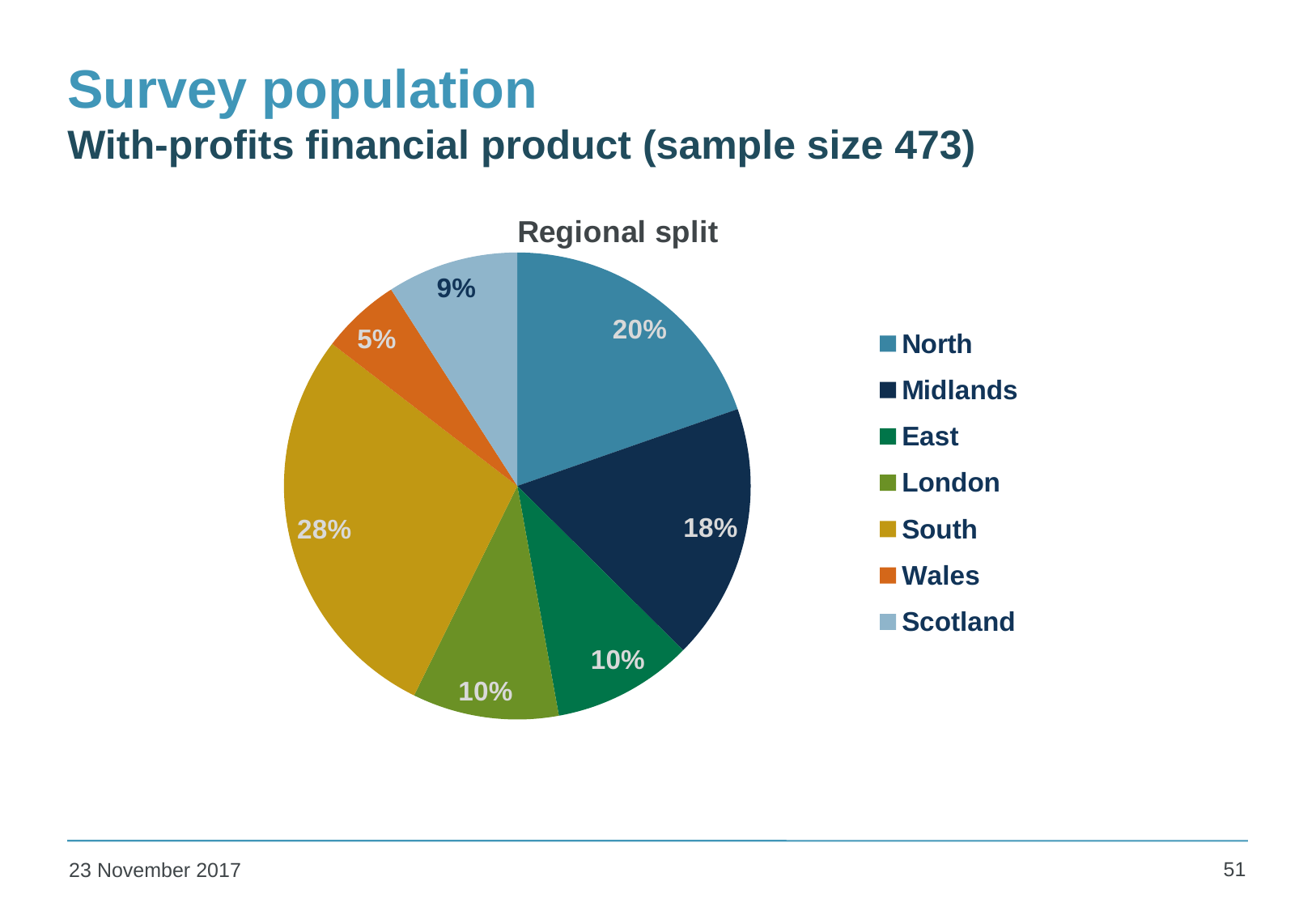
What share of the pie does North have? 20% Which region has the largest share of the pie? South What is the title of the chart? Regional split How many regions are shown in the pie chart? 7 What share of the pie does South have? 28% What kind of chart is shown on the slide? Pie chart Which has a larger share, North or Midlands? North Which region has the smallest share of the pie? Wales What share of the pie does Wales have? 5% What is the difference between the shares for South and North? 8% What share of the pie does Midlands have? 18% What share of the pie does Scotland have? 9%